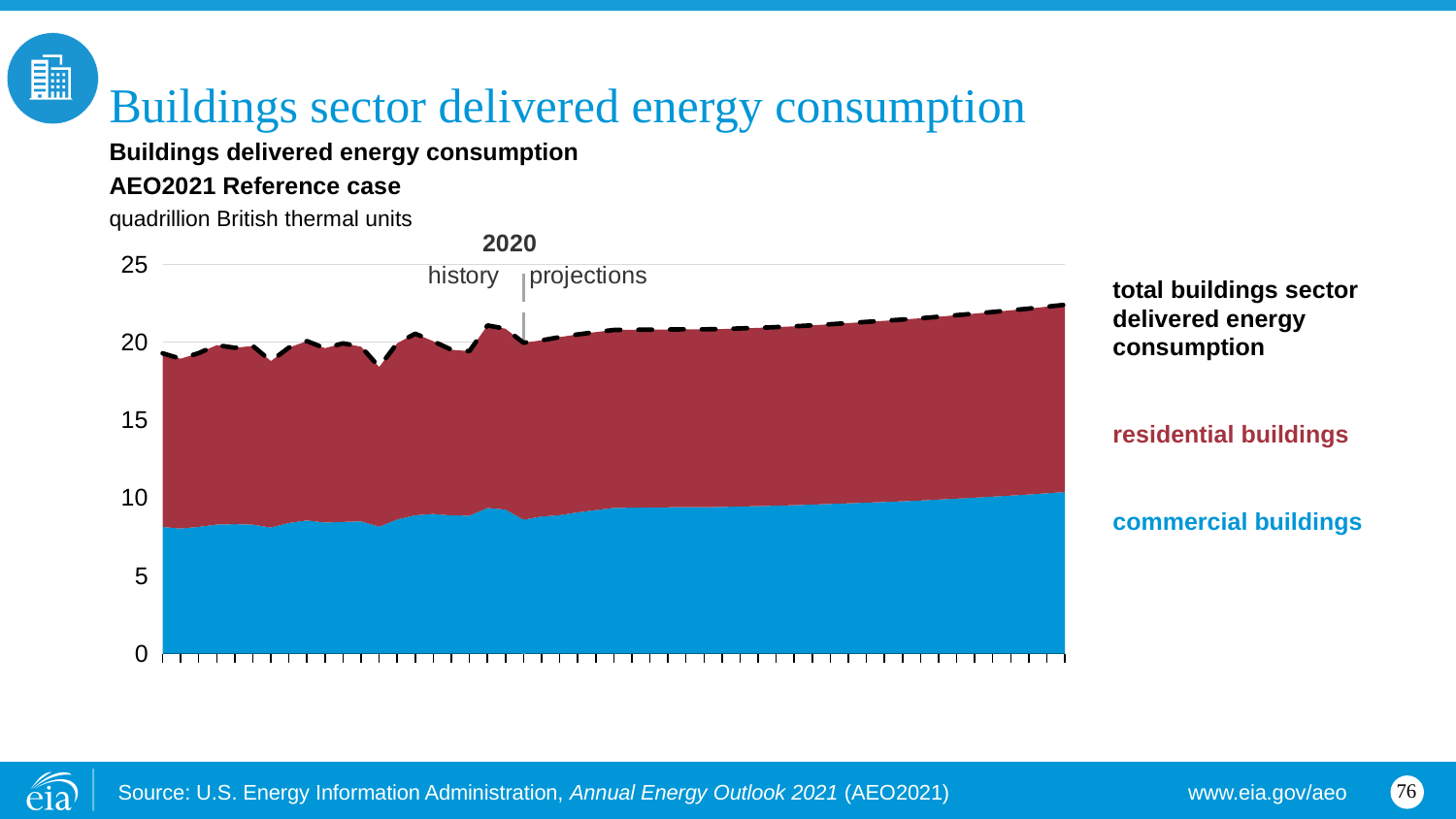
Which series accounts for more delivered energy consumption at the end of the projection period, residential buildings or commercial buildings? residential buildings Is the commercial buildings value at the start of the history period greater or less than 10? less Is the commercial buildings value at the start of the history period greater or less than 5? greater Is the total buildings sector delivered energy consumption at the end of the projection period greater or less than 25? less Does total buildings sector delivered energy consumption rise or fall over the projection period after 2020? rise What kind of chart is shown on the slide? stacked area chart How many series does the chart's legend list? 3 What year separates history from projections on the chart? 2020 Does commercial buildings delivered energy consumption rise or fall over the projection period after 2020? rise Is the highest value of the total buildings sector delivered energy consumption line found in the history period or the projection period? projection period What unit is the y axis measured in? quadrillion British thermal units